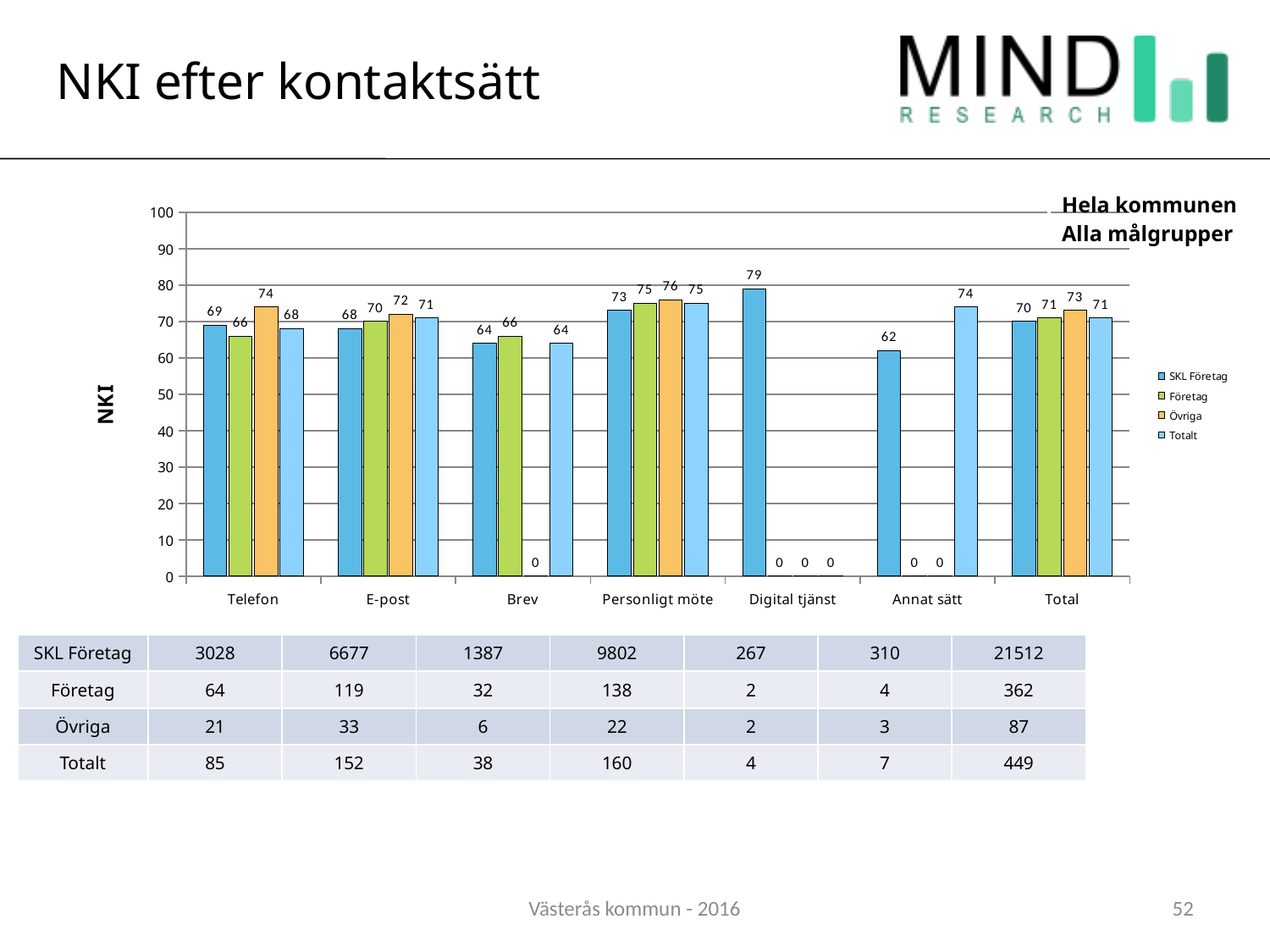
What is the NKI value for Företag for Brev? 66 Which contact method has the highest NKI value for SKL Företag? Digital tjänst What is the NKI value for Övriga for Personligt möte? 76 What is the NKI value for SKL Företag for Telefon? 69 How many contact method categories are shown on the x axis? 7 Which contact method has the lowest NKI value for SKL Företag? Annat sätt Which is larger for E-post: the SKL Företag value or the Övriga value? Övriga How many series does the legend list? 4 What is the NKI value for Totalt for Annat sätt? 74 What kind of chart is shown on the slide? Bar chart What is the difference between the Övriga value and the Företag value for Telefon? 8 What is the label on the vertical axis of the chart? NKI